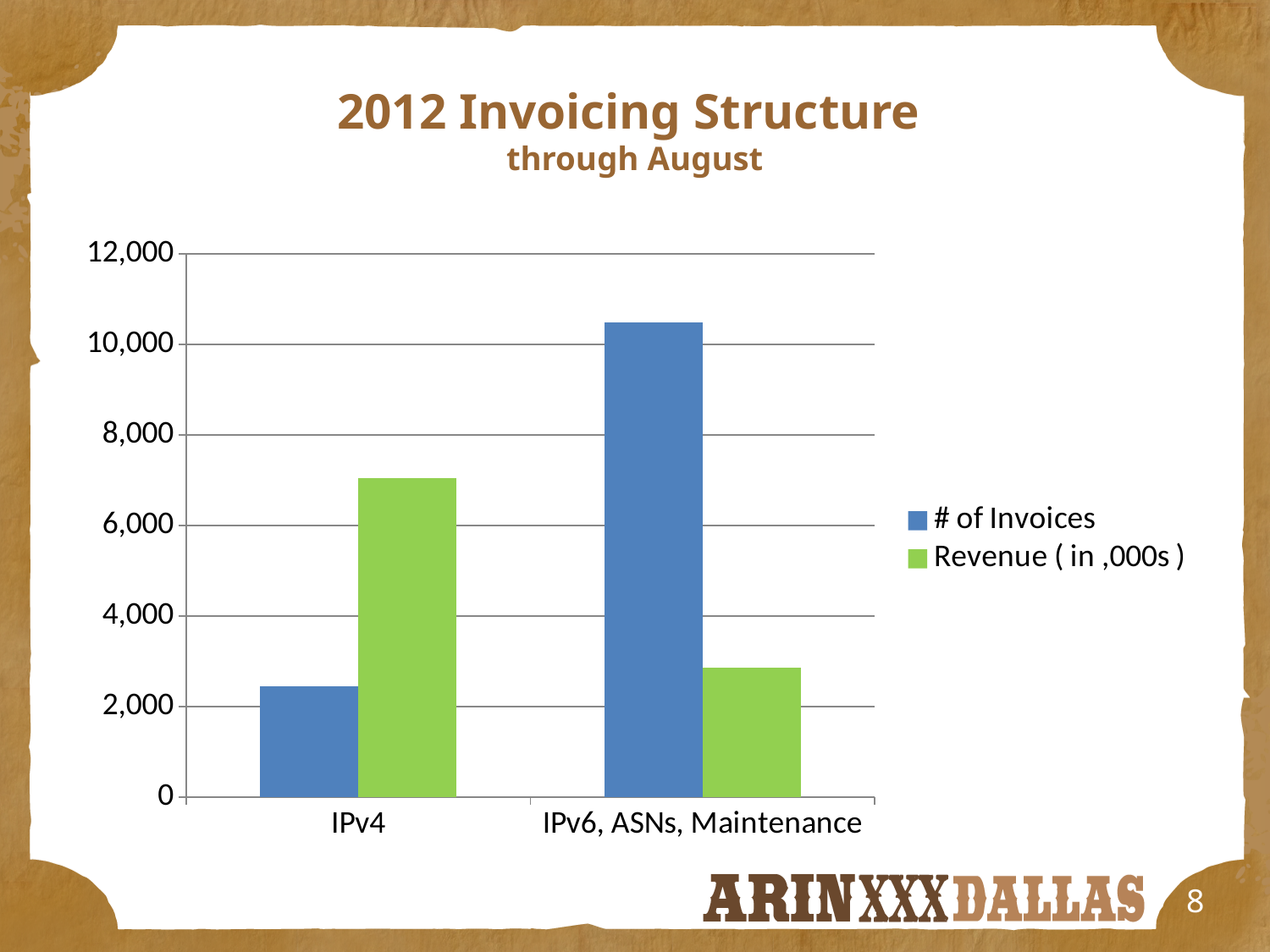
Which category has the higher Revenue ( in ,000s )? IPv4 How many categories are shown on the x axis? 2 Which category has the higher # of Invoices? IPv6, ASNs, Maintenance Which category has the lower # of Invoices? IPv4 Is the Revenue ( in ,000s ) for IPv4 greater or less than 6,000? greater Is the Revenue ( in ,000s ) for IPv6, ASNs, Maintenance greater or less than 4,000? less How many series does the legend list? 2 For IPv4, which is larger: # of Invoices or Revenue ( in ,000s )? Revenue ( in ,000s ) Is the # of Invoices for IPv4 greater or less than 4,000? less What kind of chart is shown on the slide? bar chart What is the title of the chart on the slide? 2012 Invoicing Structure through August